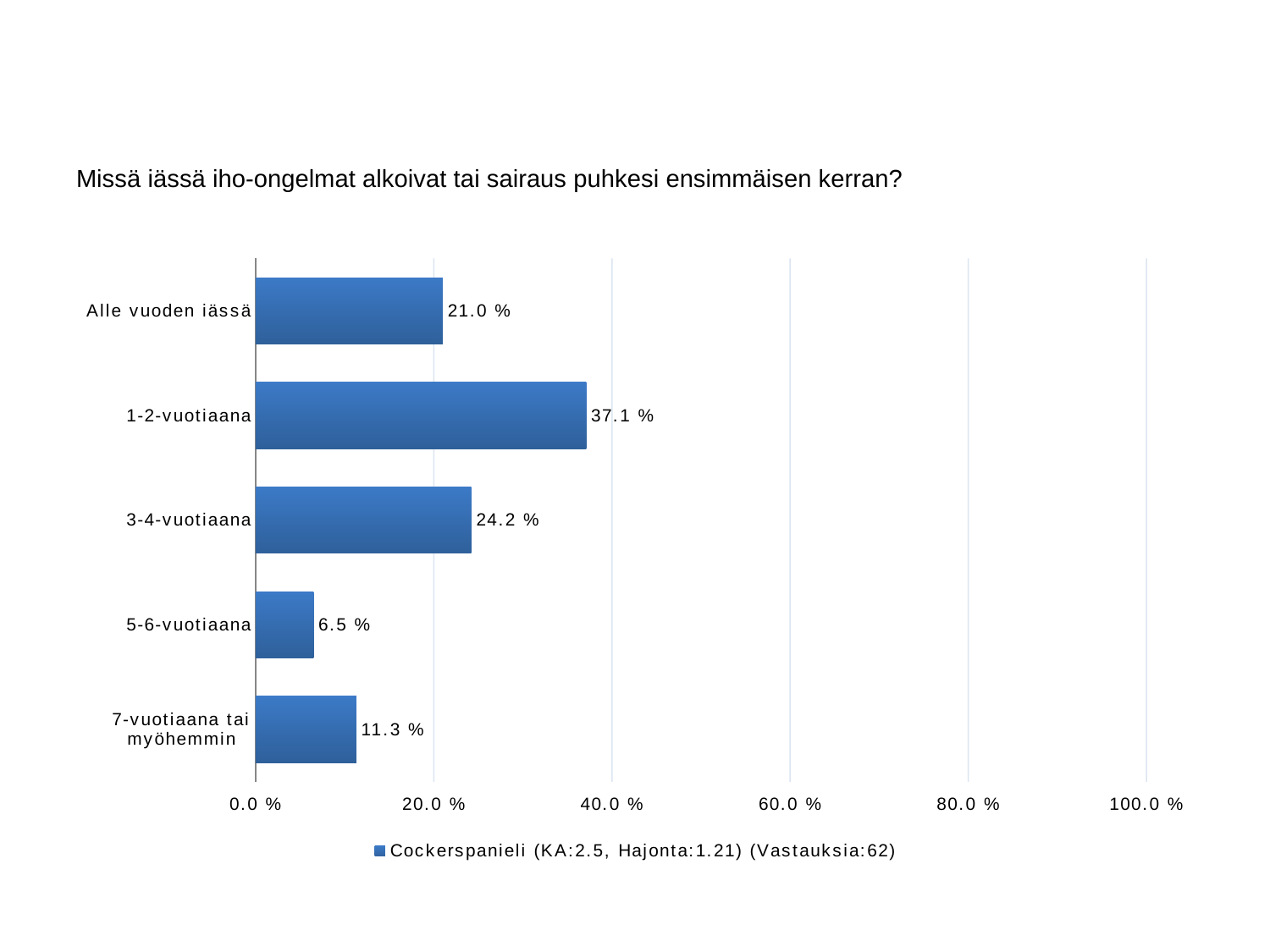
Is the value for "1-2-vuotiaana" greater or less than 40.0 %? less What is the difference between the values for "1-2-vuotiaana" and "3-4-vuotiaana"? 12.9 % Which category has the lowest value? 5-6-vuotiaana How many series does the legend list? 1 What is the title of the chart? Missä iässä iho-ongelmat alkoivat tai sairaus puhkesi ensimmäisen kerran? What is the value for "7-vuotiaana tai myöhemmin"? 11.3 % Which category has the highest value? 1-2-vuotiaana What is the value for "Alle vuoden iässä"? 21.0 % What kind of chart is shown on the slide? bar chart How many categories are shown on the chart? 5 Which is larger, the value for "3-4-vuotiaana" or the value for "Alle vuoden iässä"? 3-4-vuotiaana What is the value for "1-2-vuotiaana"? 37.1 %